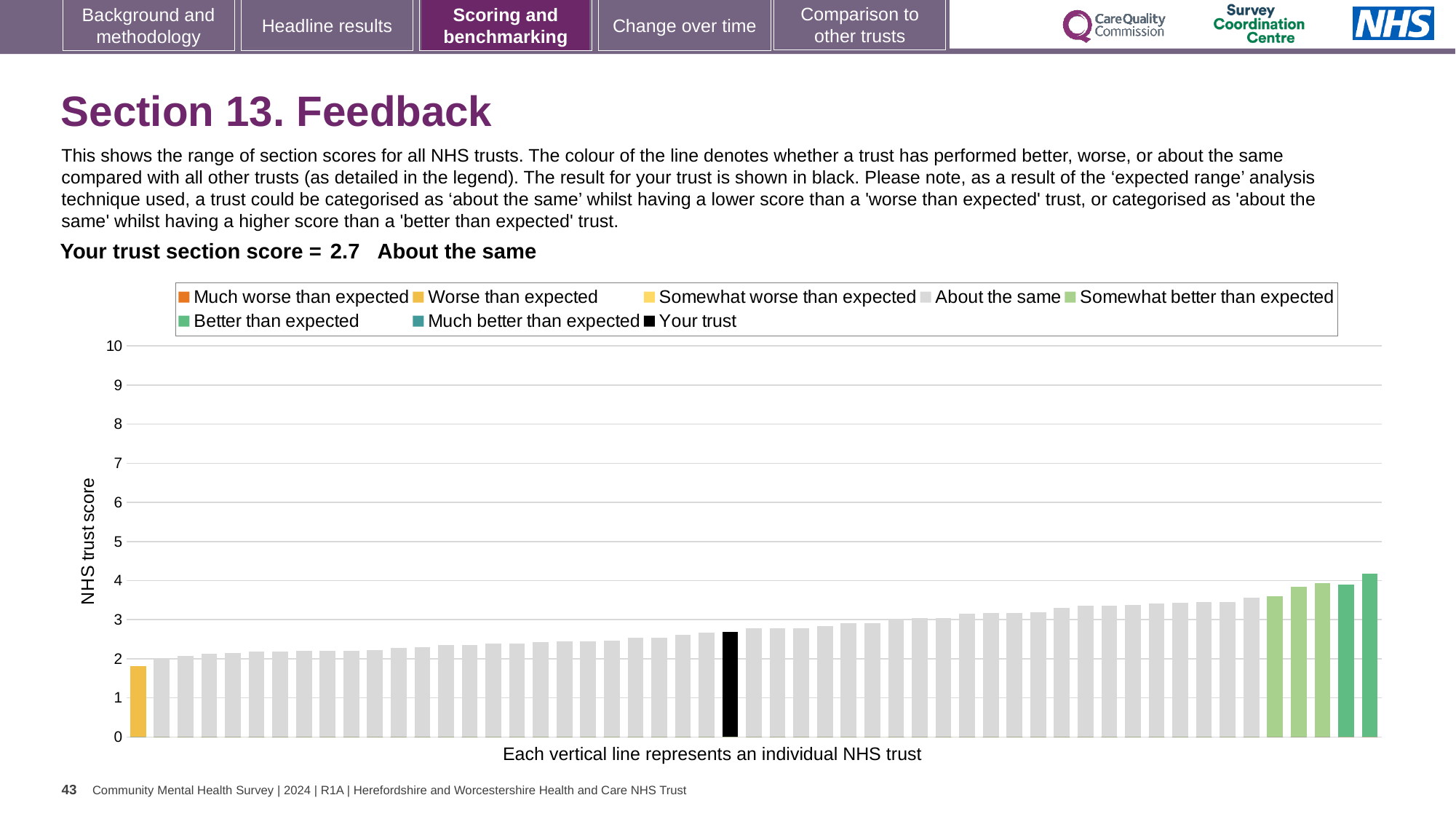
What is the section score for your trust shown on the slide? 2.7 Is the value of the highest bar greater or less than 5? less Do the bar values rise or fall from left to right along the x axis? Rise How is your trust's section score categorised compared with other trusts? About the same Is the value of the leftmost (yellow) bar greater or less than 2? less Is the value for your trust (the black bar) greater or less than 3? less What is the label on the y axis of the chart? NHS trust score What is the highest tick value shown on the y axis? 10 What kind of chart is used to show the NHS trust scores? Bar chart Which is larger: your trust's score (black bar) or the leftmost yellow bar? Your trust's score How many entries does the chart legend list? 8